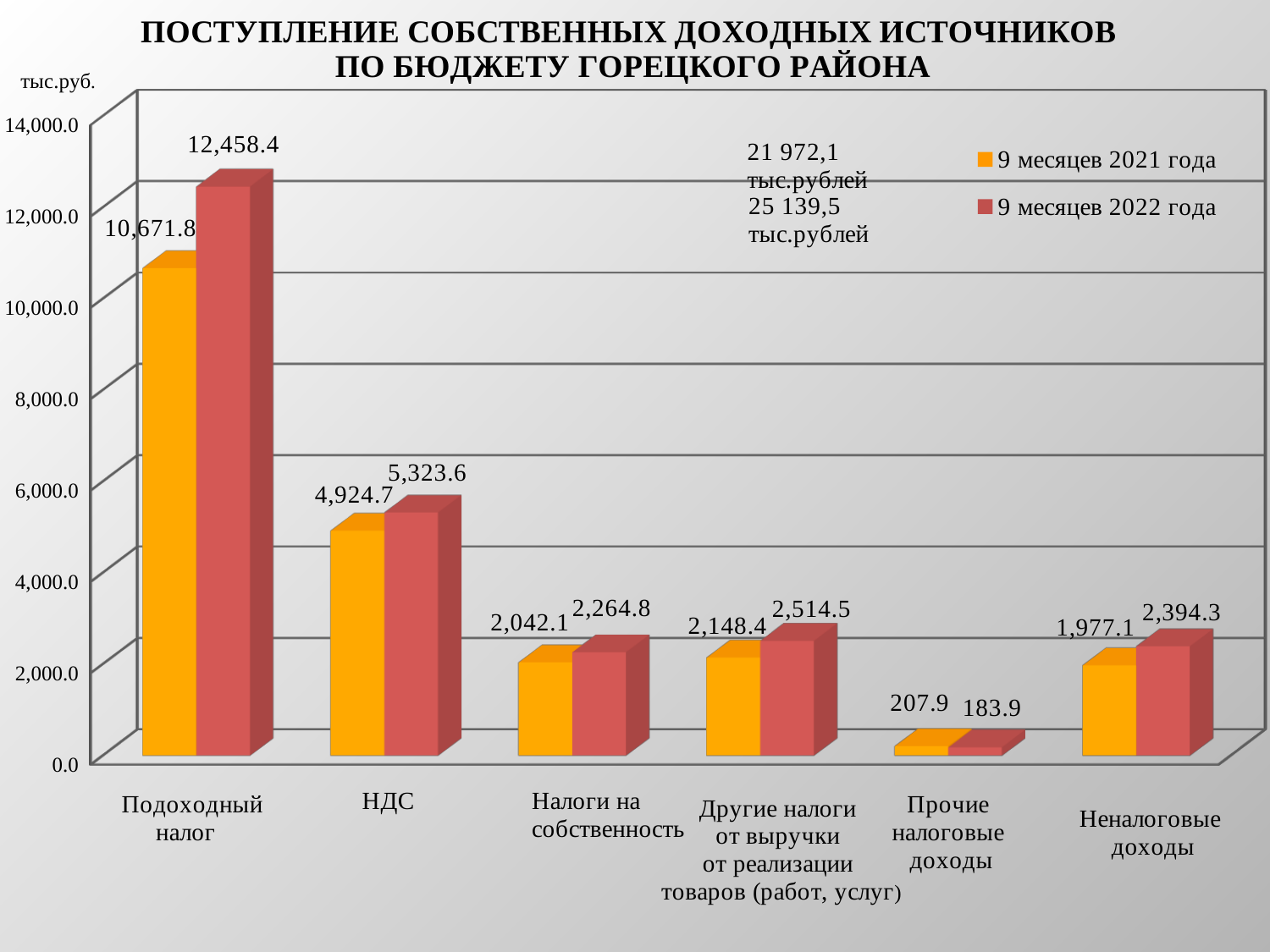
What is the value for НДС in the 9 месяцев 2021 года series? 4,924.7 What kind of chart is shown on the slide? Bar chart How many series does the legend list? 2 Which category has the highest value in the 9 месяцев 2021 года series? Подоходный налог Which category has the lowest value in the 9 месяцев 2022 года series? Прочие налоговые доходы What is the difference between the 9 месяцев 2021 года and 9 месяцев 2022 года values for Прочие налоговые доходы? 24.0 What is the value for Прочие налоговые доходы in the 9 месяцев 2022 года series? 183.9 What is the difference between the 9 месяцев 2022 года and 9 месяцев 2021 года values for Подоходный налог? 1,786.6 What is the value for Подоходный налог in the 9 месяцев 2022 года series? 12,458.4 For Прочие налоговые доходы, which series has the larger value: 9 месяцев 2021 года or 9 месяцев 2022 года? 9 месяцев 2021 года How many categories are shown on the x axis? 6 What is the value for Неналоговые доходы in the 9 месяцев 2021 года series? 1,977.1